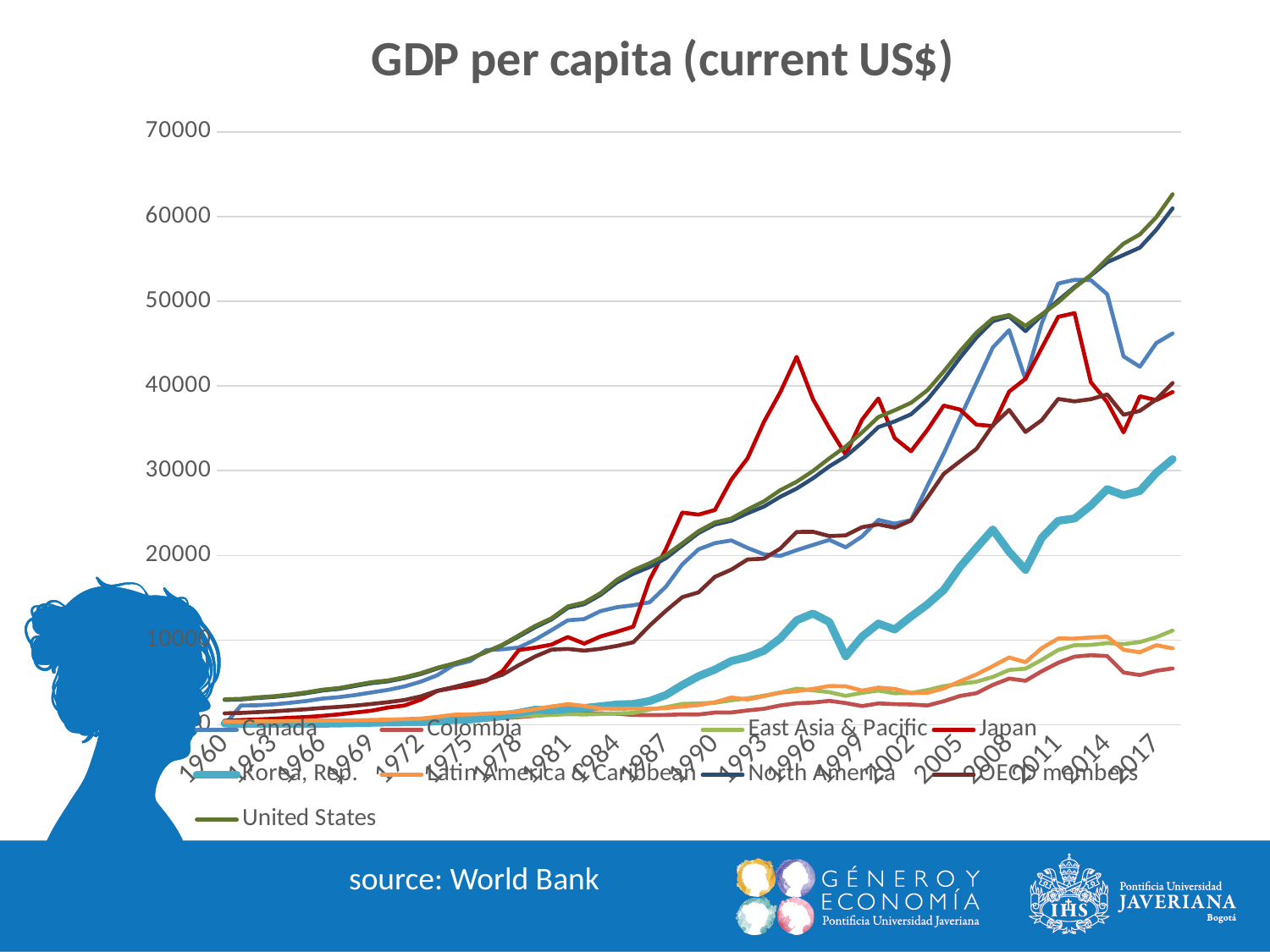
In 2017, which is larger: the value for Japan or the value for Korea, Rep.? Japan In 2017, which is larger: the value for Canada or the value for OECD members? Canada Which series has the lowest GDP per capita at the end of the period (2017)? Colombia Is the peak value for Japan in the mid-1990s greater or less than 40000? greater Does the value for Korea, Rep. generally rise or fall from 1960 to 2017? rise Is the value for Canada in 2017 greater or less than 50000? less What kind of chart is shown on the slide? line chart What is the title of the chart? GDP per capita (current US$) What is the source cited for the chart data? World Bank How many series does the legend list? 9 Is the value for Colombia in 2017 greater or less than 10000? less